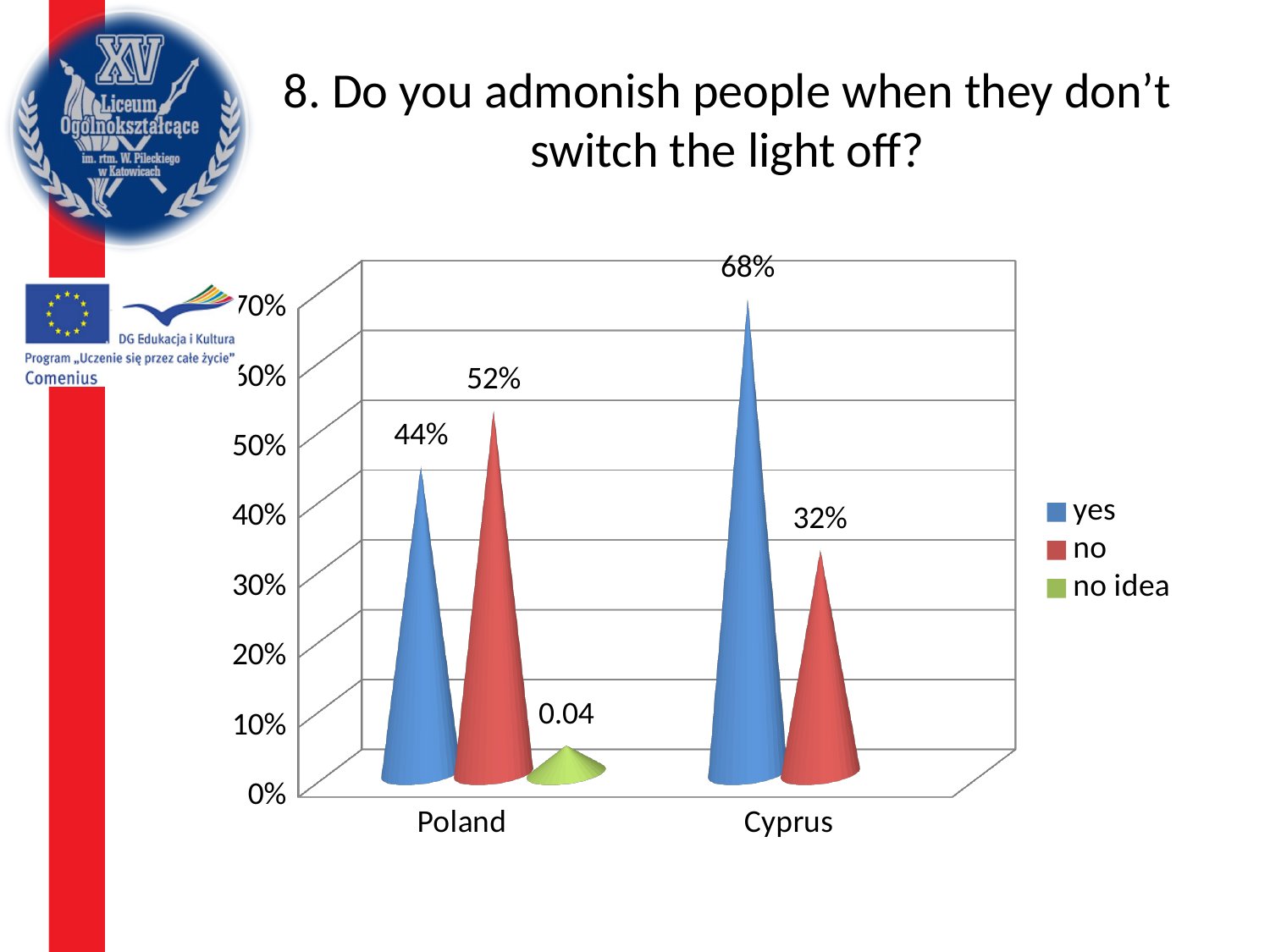
How many series does the legend list? 3 Which country has the higher value for "yes"? Cyprus What is the value for "yes" in Poland? 44% In Poland, which is larger: "yes" or "no"? no Is the value for "no" in Cyprus greater or less than 40%? less Which country and answer has the highest value on the chart? Cyprus, yes (68%) What colour represents the "no idea" series in the legend? green What is the value for "no" in Cyprus? 32% What is the difference between "yes" and "no" in Cyprus? 36% What is the difference between "no" and "yes" in Poland? 8% How many countries are shown on the x axis? 2 What is the value for "no idea" in Poland, as printed on the chart? 0.04